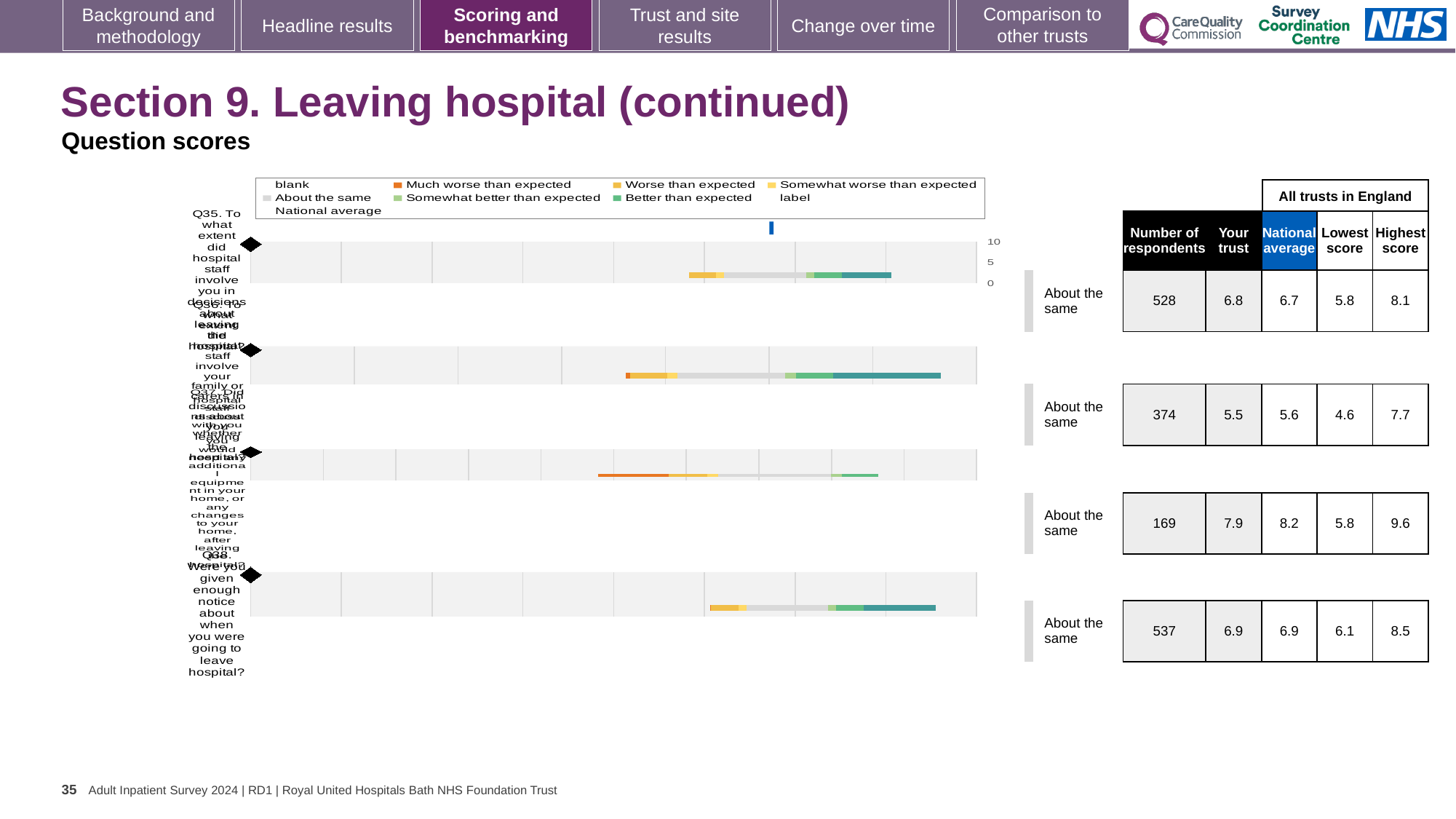
What benchmark category is shown for Q38? About the same What is the national average score for Q37? 8.2 Which question has the lowest 'Your trust' score? Q36 For Q35, which is larger: the 'Your trust' score or the national average? Your trust For Q37, what is the difference between the highest score and the lowest score across all trusts in England? 3.8 What colour does the legend use for 'Much worse than expected'? orange Which question has the highest 'Your trust' score? Q37 What is the highest score among all trusts in England for Q38? 8.5 According to the table beside the chart, how many respondents answered Q35? 528 What kind of chart is used to show the question scores on this slide? bar chart What is the 'Your trust' score for Q36 shown in the table? 5.5 How many questions (bars) are plotted in the chart? 4